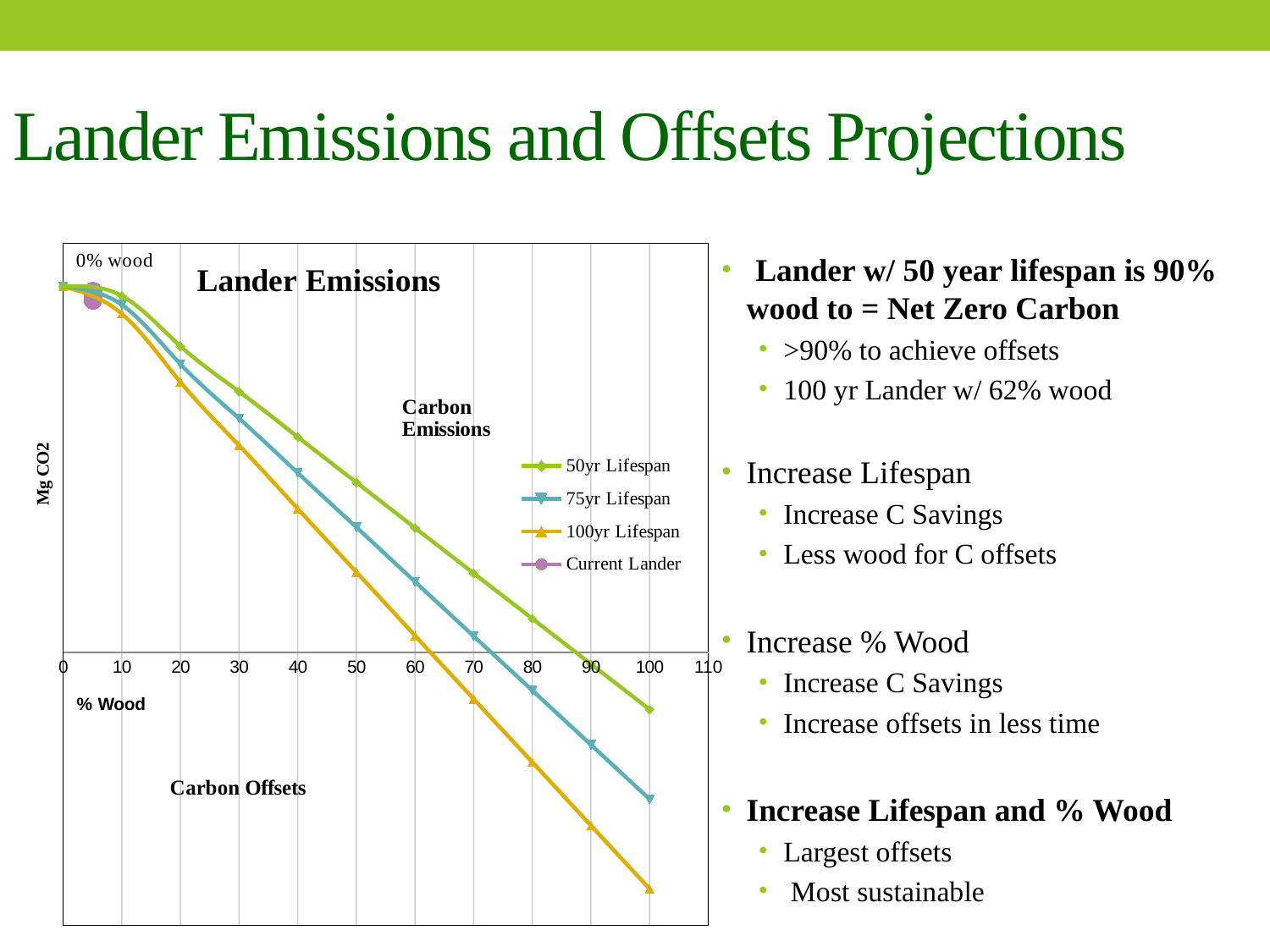
What kind of chart is shown on the slide? line chart In the Lander Emissions chart, which lifespan series has the highest value at 100% wood? 50yr Lifespan What is the label of the x axis of the Lander Emissions chart? % Wood What is the highest % Wood tick shown on the x axis of the Lander Emissions chart? 110 In the Lander Emissions chart, at 80% wood, which is lower: 75yr Lifespan or 100yr Lifespan? 100yr Lifespan In the Lander Emissions chart, does the 100yr Lifespan line cross the x axis at a % Wood value greater or less than 70? less How many series does the legend of the Lander Emissions chart list? 4 In the Lander Emissions chart, at 60% wood, is the value for 50yr Lifespan larger or smaller than the value for 100yr Lifespan? larger In the Lander Emissions chart, do the lifespan lines rise or fall as % Wood increases? fall In the Lander Emissions chart, does the 50yr Lifespan line cross the x axis at a % Wood value greater or less than 80? greater In the Lander Emissions chart, which lifespan series has the lowest value at 100% wood? 100yr Lifespan What is the title of the chart on the slide? Lander Emissions